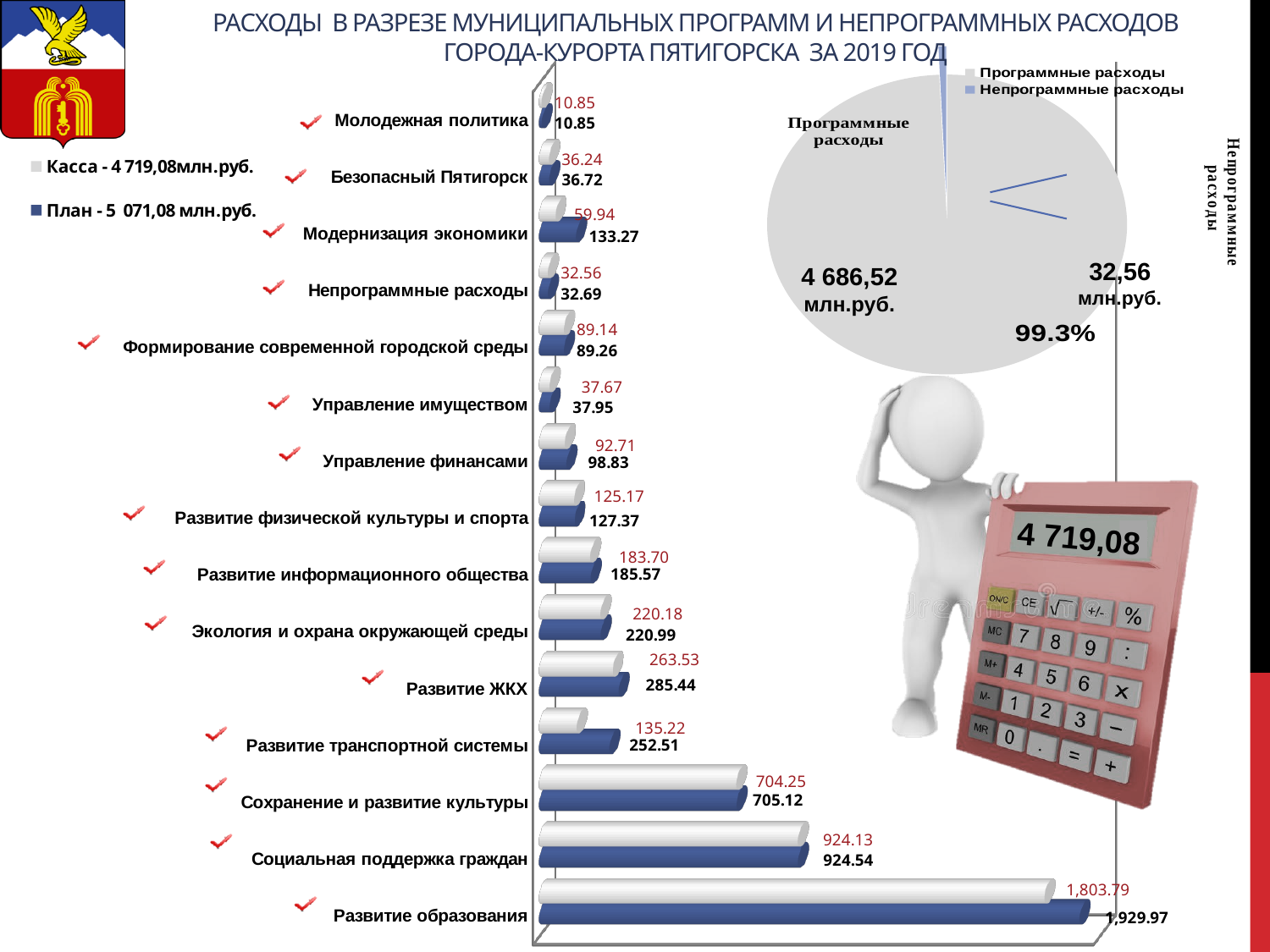
On the bar chart, which category has the lowest Касса value? Молодежная политика On the pie chart, what value is shown for Программные расходы? 4 686,52 млн.руб. On the bar chart, what is the Касса value for Сохранение и развитие культуры? 704.25 On the bar chart, which category has the highest План value? Развитие образования On the bar chart, what is the Касса value for Развитие образования? 1,803.79 On the bar chart, what is the difference between the План and Касса values for Модернизация экономики? 73.33 On the bar chart, what is the План value for Развитие транспортной системы? 252.51 On the pie chart, what share is shown for Программные расходы? 99.3% How many series does the bar chart legend list? 2 On the bar chart, which is larger: the Касса value for Развитие ЖКХ or the Касса value for Развитие транспортной системы? Развитие ЖКХ What type of chart is the chart on the left side of the slide? bar chart How many categories are shown on the bar chart? 15